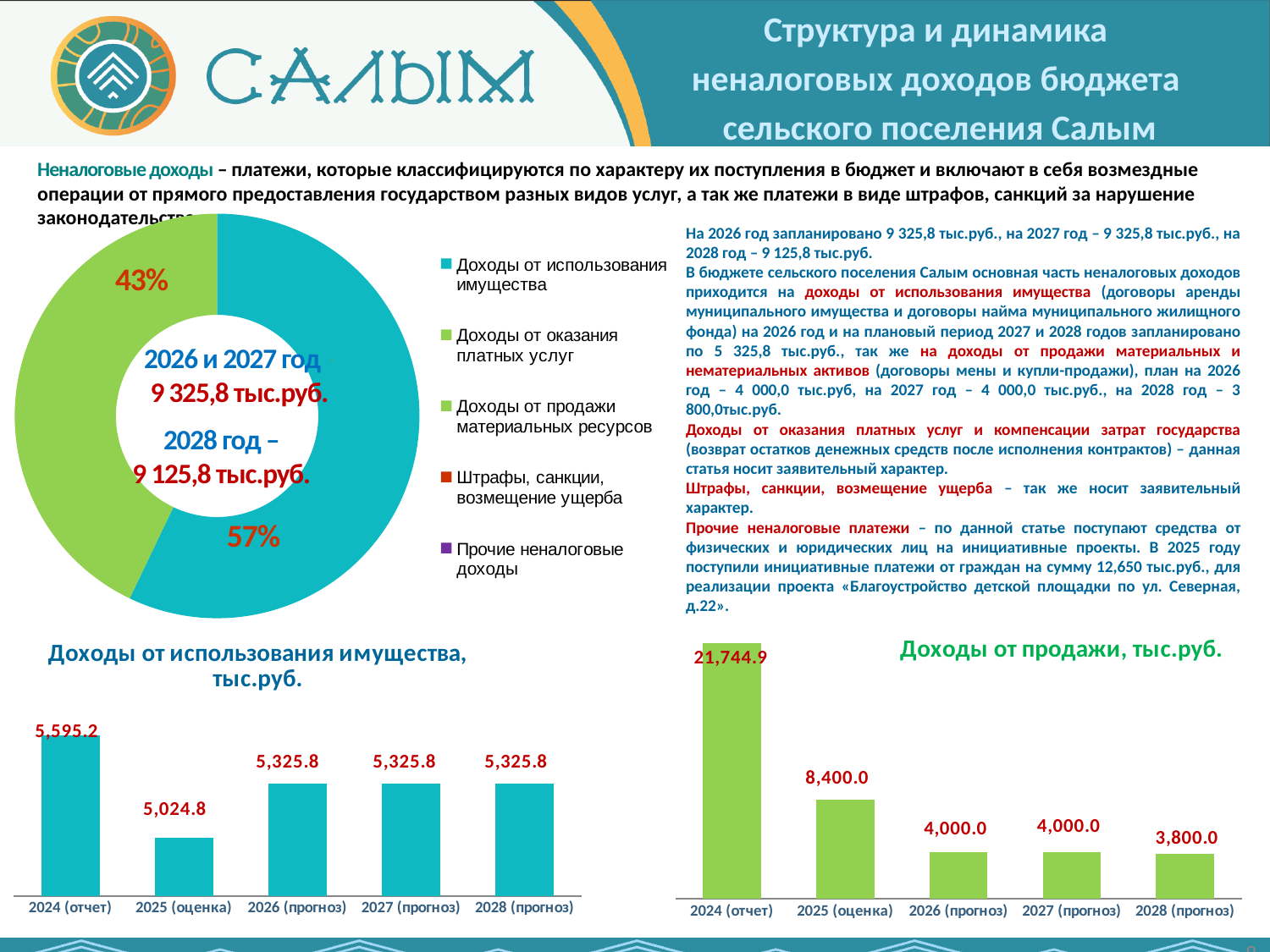
In the 'Доходы от использования имущества, тыс.руб.' chart, what is the value for 2025 (оценка)? 5,024.8 In the 'Доходы от продажи, тыс.руб.' chart, do the values rise or fall from 2024 to 2028? fall In the 'Доходы от использования имущества, тыс.руб.' chart, what is the difference between the 2024 (отчет) and 2025 (оценка) values? 570.4 In the 'Доходы от продажи, тыс.руб.' chart, which year has the highest value? 2024 (отчет) In the 'Доходы от использования имущества, тыс.руб.' chart, which year has the lowest value? 2025 (оценка) In the 'Доходы от продажи, тыс.руб.' chart, what is the value for 2024 (отчет)? 21,744.9 What type of chart is the 'Доходы от использования имущества, тыс.руб.' chart? bar chart In the 'Доходы от продажи, тыс.руб.' chart, what is the difference between the 2024 (отчет) and 2025 (оценка) values? 13,344.9 In the 'Доходы от продажи, тыс.руб.' chart, what is the value for 2028 (прогноз)? 3,800.0 How many entries does the legend of the donut chart at the top left list? 5 In the 'Доходы от использования имущества, тыс.руб.' chart, what is the value for 2024 (отчет)? 5,595.2 How many bars are in the 'Доходы от использования имущества, тыс.руб.' chart? 5